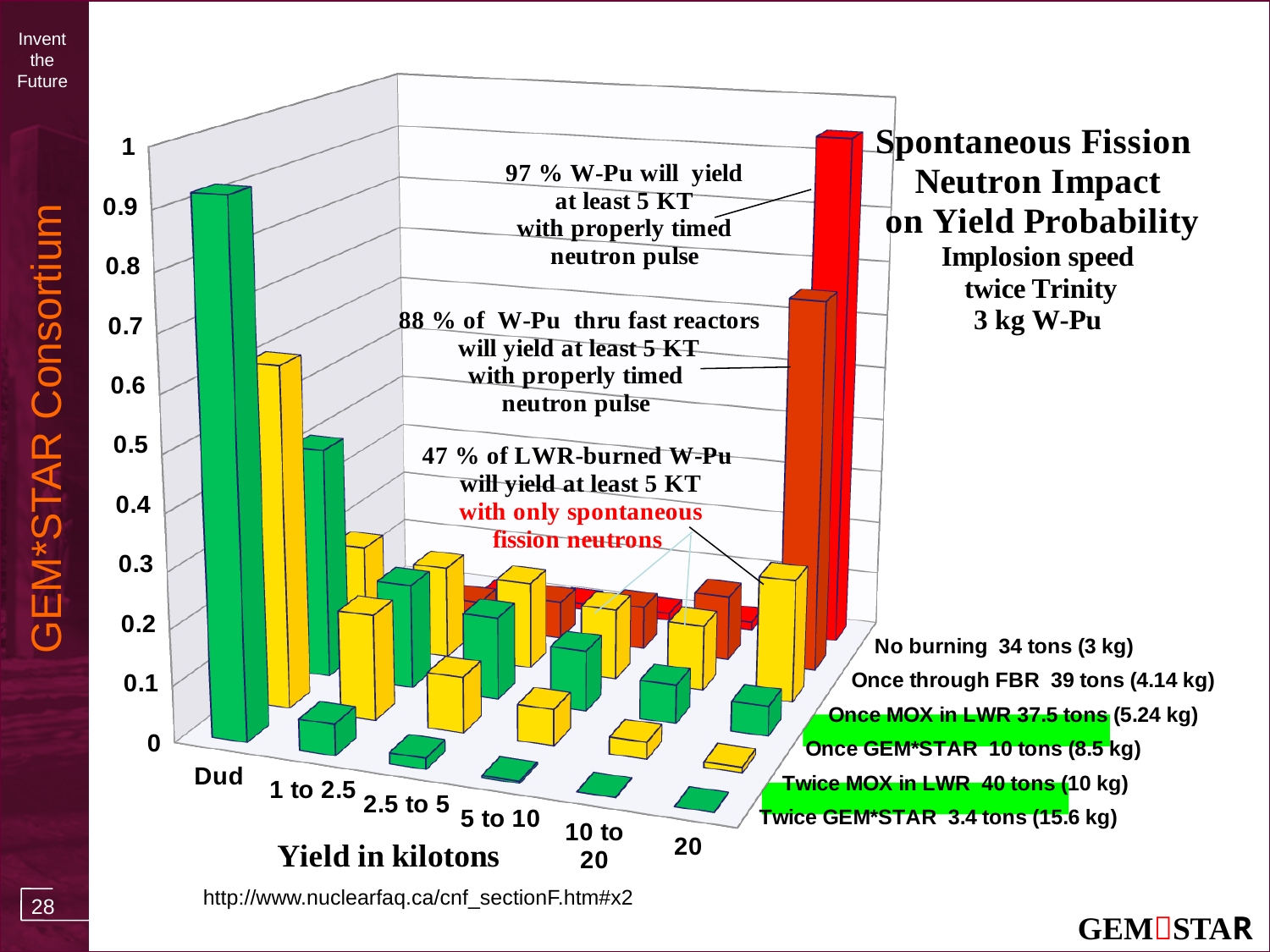
What is the title of the x axis of the chart? Yield in kilotons Is the value for the 20 kiloton category in the No burning series greater or less than 0.5? greater Which series has the tallest bar in the 20 kiloton category? No burning 34 tons (3 kg) How many fuel-burning series are listed beside the chart? 6 How many yield categories are shown along the x axis of the chart? 6 Which series has the tallest bar in the Dud category? Twice GEM*STAR 3.4 tons (15.6 kg) Is the value for the 5 to 10 category in the Twice GEM*STAR series greater or less than 0.3? less Is the value for the Dud category in the Twice GEM*STAR series greater or less than 0.5? greater Do the values for the Twice GEM*STAR series rise or fall from Dud to 20 along the x axis? fall In the Dud category, which is larger: the value for Twice GEM*STAR or the value for No burning? Twice GEM*STAR What is the highest value shown on the vertical axis of the chart? 1 What kind of chart is shown on the slide? bar chart